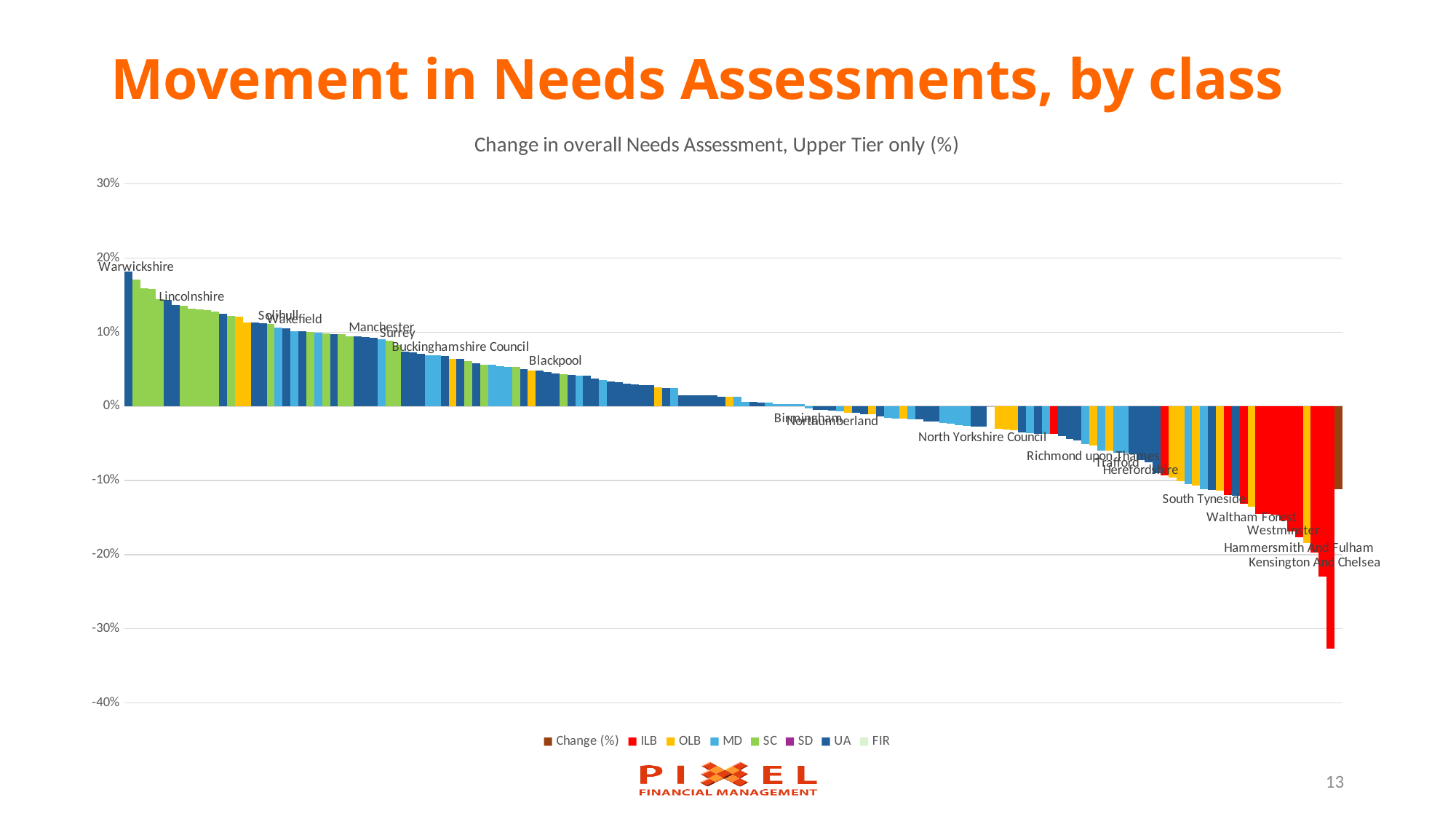
What is the title of the chart? Change in overall Needs Assessment, Upper Tier only (%) How many entries does the legend list? 8 Is the value for Kensington And Chelsea greater or less than -30%? greater Which colour represents the ILB class in the legend? red Do the values rise or fall moving from left to right along the x axis? fall Is the value for Blackpool greater or less than 10%? less Is the value for Westminster greater or less than -10%? less Which labelled authority has the lowest change in overall Needs Assessment? Kensington And Chelsea Which has the larger value, Warwickshire or Lincolnshire? Warwickshire Which labelled authority has the highest change in overall Needs Assessment? Warwickshire What kind of chart is shown on the slide? bar chart